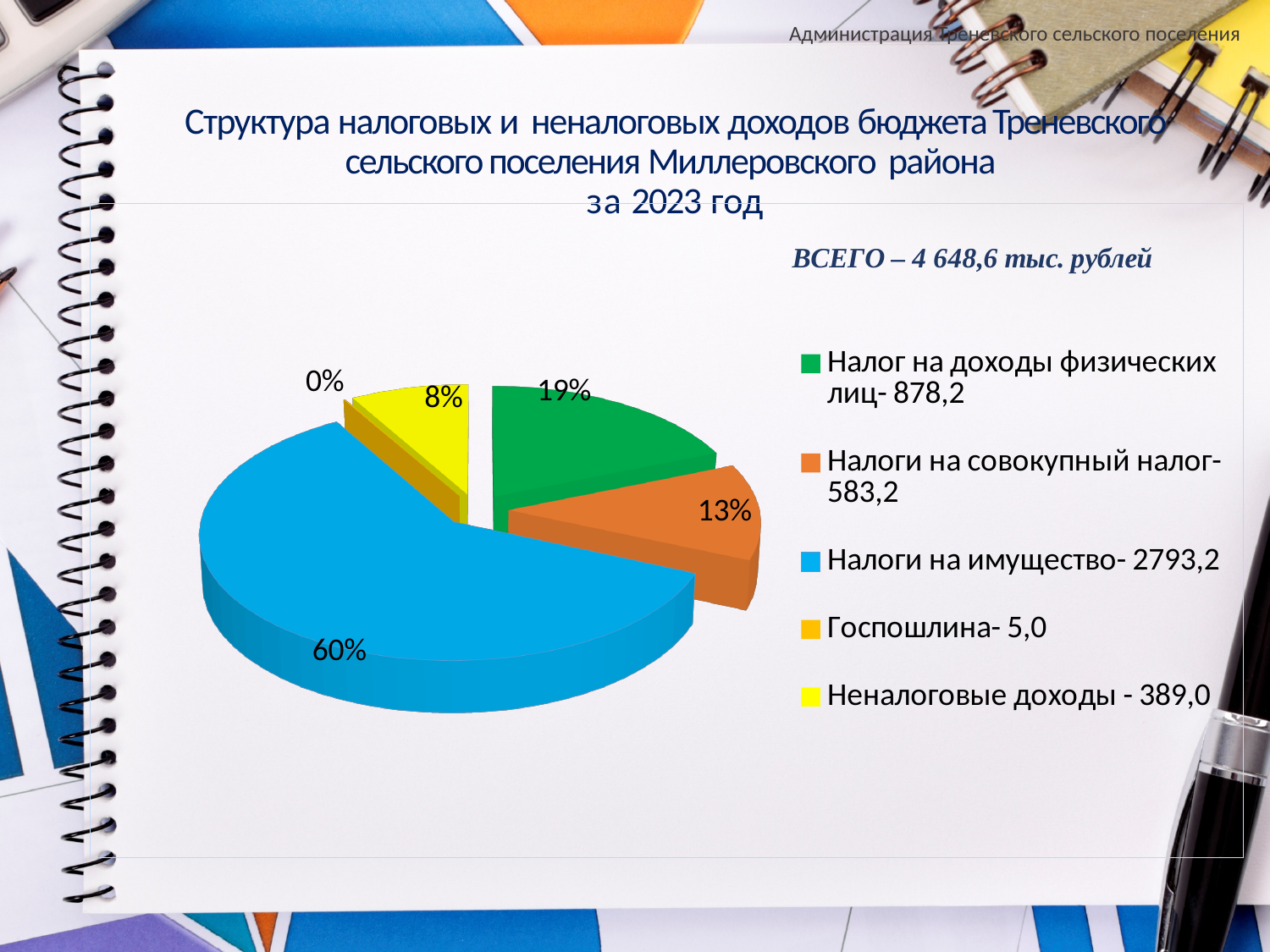
What share of the pie does "Налоги на совокупный налог" take? 13% What total amount is stated above the legend (ВСЕГО)? 4 648,6 тыс. рублей How many entries does the legend list? 5 Which category has the largest slice of the pie? Налоги на имущество What share of the pie does "Налог на доходы физических лиц" take? 19% What share of the pie does "Налоги на имущество" take? 60% How many slices does the pie chart have? 5 What kind of chart is shown on the slide? Pie chart What percentage is shown for "Госпошлина"? 0% Which category has the smallest slice of the pie? Госпошлина What is the difference in percentage points between the "Налоги на имущество" slice and the "Налог на доходы физических лиц" slice? 41 percentage points